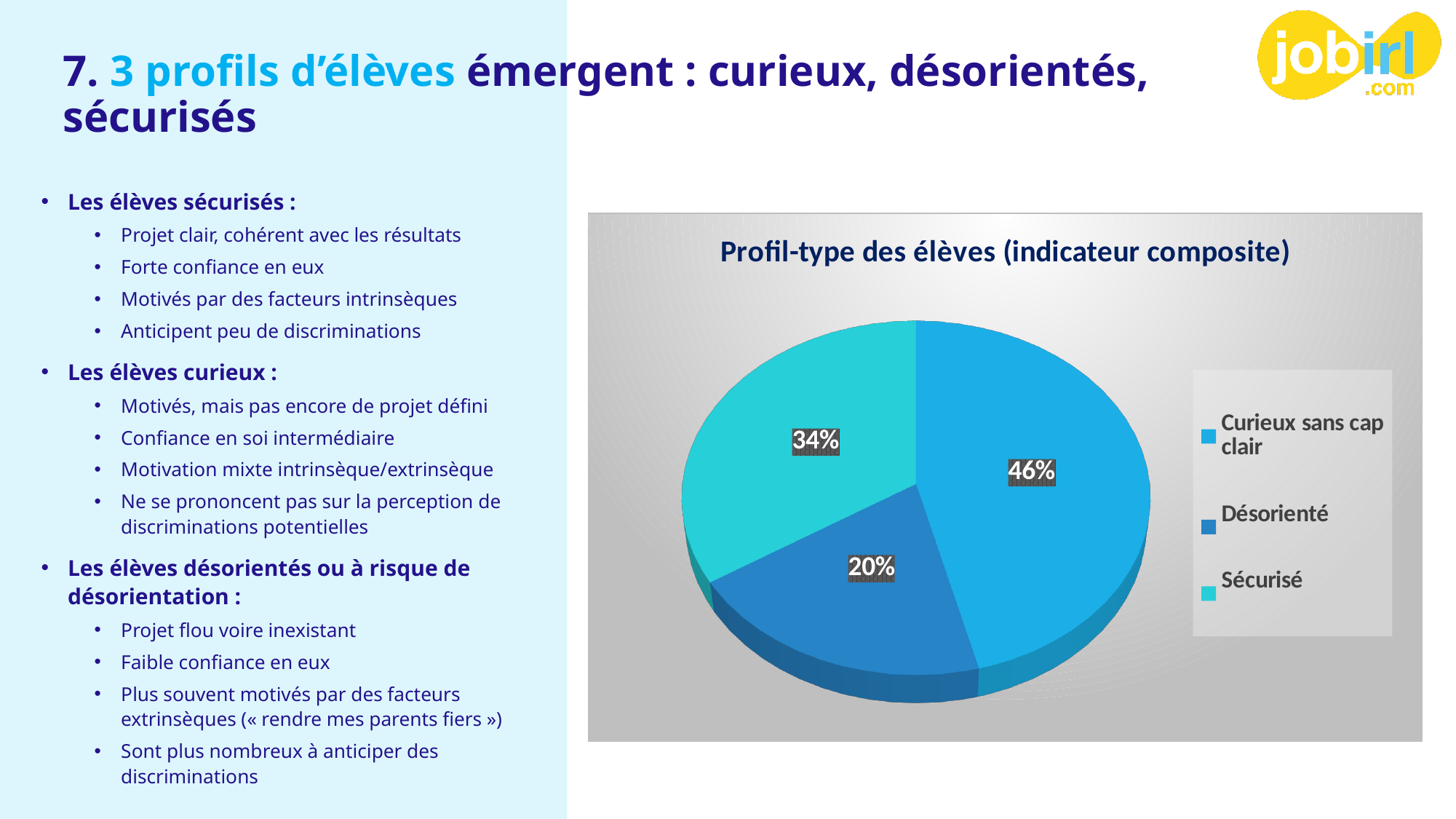
What share of the pie is labelled for 'Désorienté'? 20% What is the combined share of 'Désorienté' and 'Sécurisé'? 54% Which category has the smallest slice of the pie? Désorienté What share of the pie is labelled for 'Sécurisé'? 34% Which is larger, the share for 'Sécurisé' or the share for 'Désorienté'? Sécurisé How many entries does the legend list? 3 What is the title of the chart? Profil-type des élèves (indicateur composite) What share of the pie is labelled for 'Curieux sans cap clair'? 46% What type of chart is shown on the slide? Pie chart How many categories does the pie chart show? 3 Which category has the largest slice of the pie? Curieux sans cap clair What is the difference in percentage points between 'Curieux sans cap clair' and 'Sécurisé'? 12